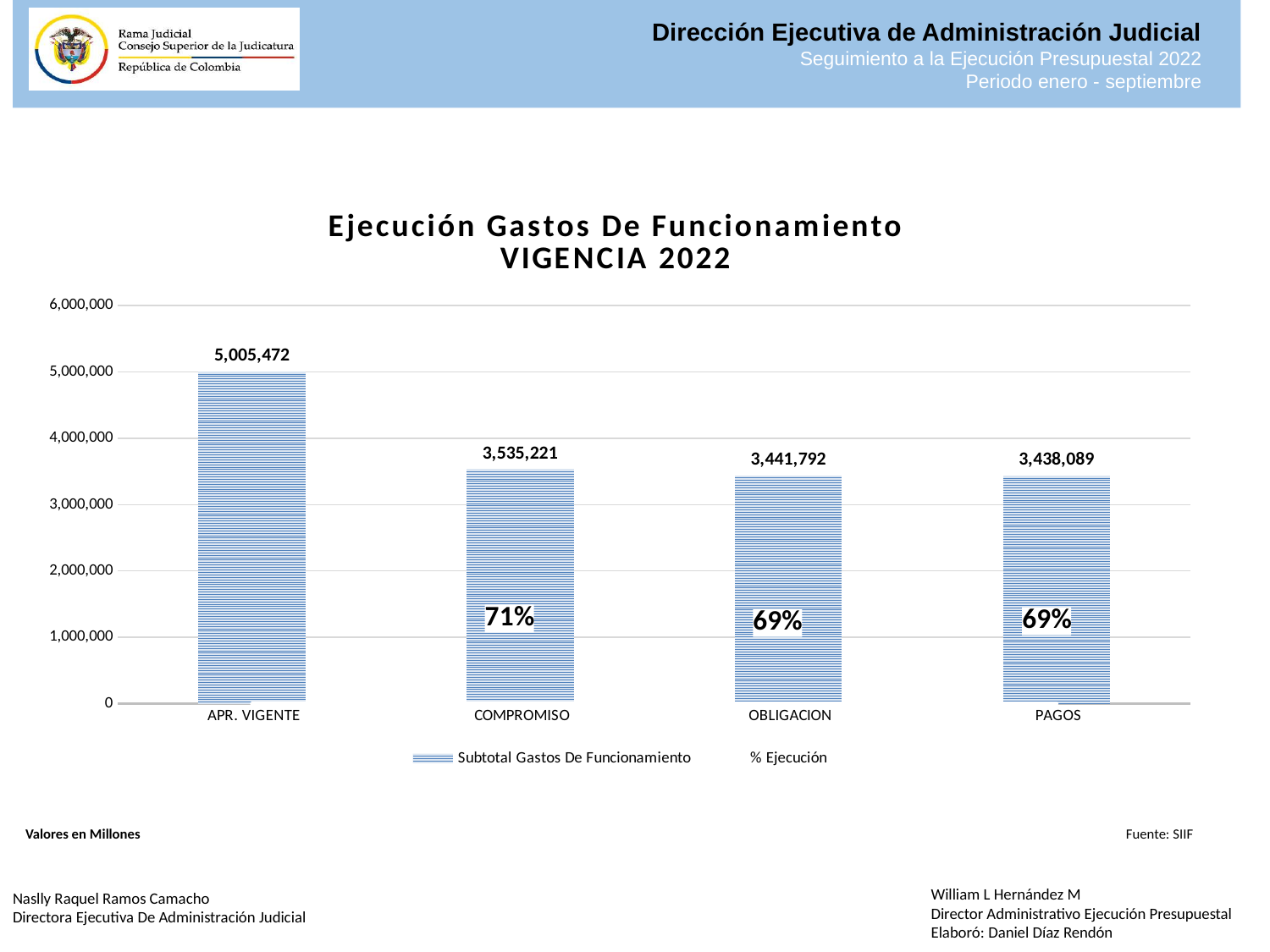
What is the value for APR. VIGENTE? 5,005,472 What kind of chart is this? Bar chart Which is larger, the value for COMPROMISO or the value for OBLIGACION? COMPROMISO What is the % Ejecución shown for COMPROMISO? 71% What is the difference between the values for APR. VIGENTE and COMPROMISO? 1,470,251 What is the value for OBLIGACION? 3,441,792 What is the value for PAGOS? 3,438,089 How many categories are shown on the x axis? 4 What is the value for COMPROMISO? 3,535,221 Which category has the lowest value? PAGOS Which category has the highest value? APR. VIGENTE What is the % Ejecución shown for PAGOS? 69%